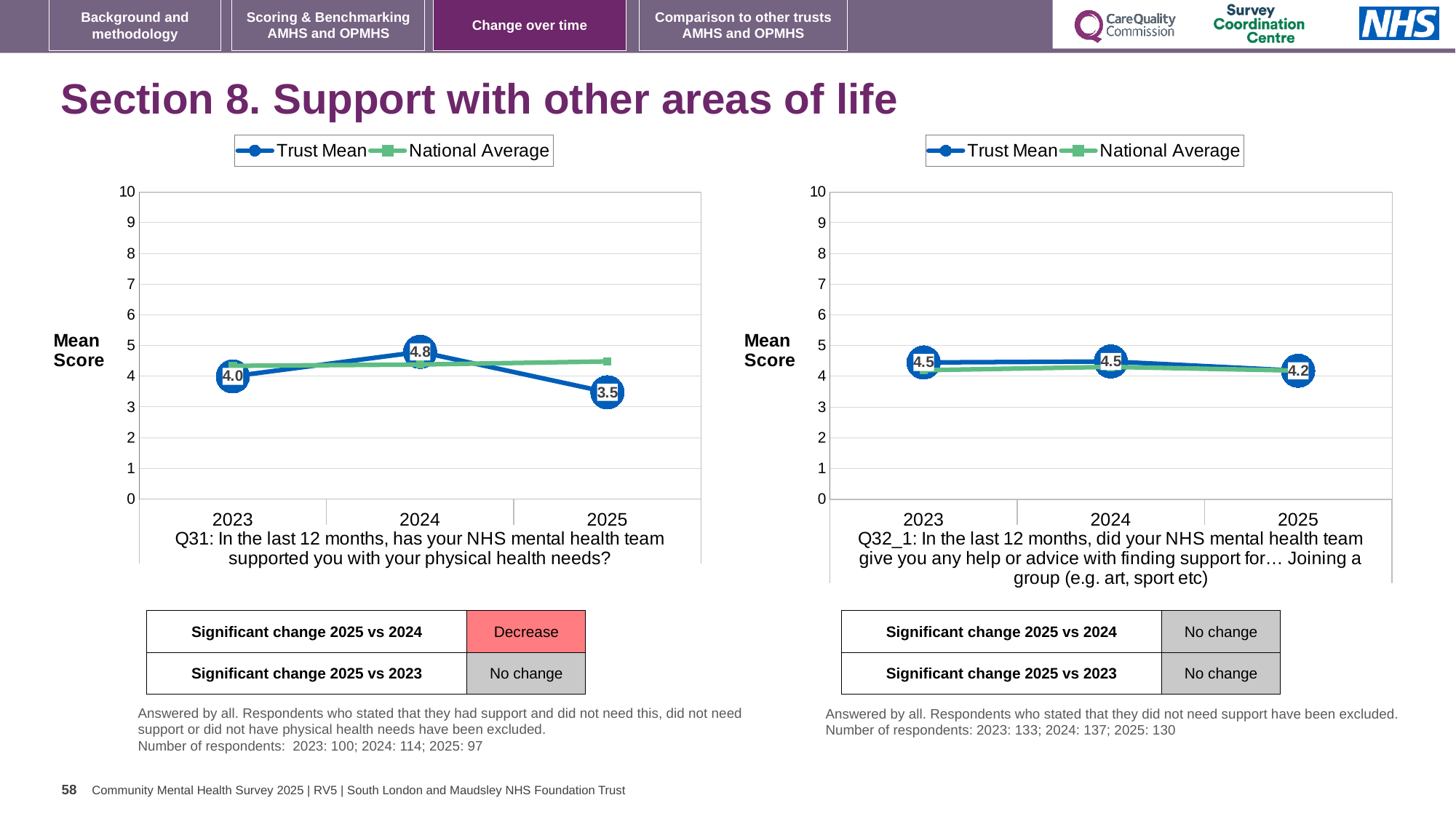
In the left chart (Q31), is the National Average for 2025 greater or less than 5? less How many series does the legend of the right chart (Q32_1) list? 2 In the left chart (Q31), which year has the highest Trust Mean? 2024 In the right chart (Q32_1), does the Trust Mean rise or fall from 2024 to 2025? fall In the left chart (Q31), what is the Trust Mean for 2024? 4.8 In the left chart (Q31), which year has the lowest Trust Mean? 2025 In the left chart (Q31), what is the difference between the Trust Mean for 2024 and 2025? 1.3 In the right chart (Q32_1), what is the difference between the Trust Mean for 2023 and 2025? 0.3 In the left chart (Q31), what is the Trust Mean for 2025? 3.5 In the right chart (Q32_1), what is the Trust Mean for 2025? 4.2 In the left chart (Q31), is the Trust Mean larger in 2023 or 2024? 2024 What kind of chart is the left chart (Q31)? line chart